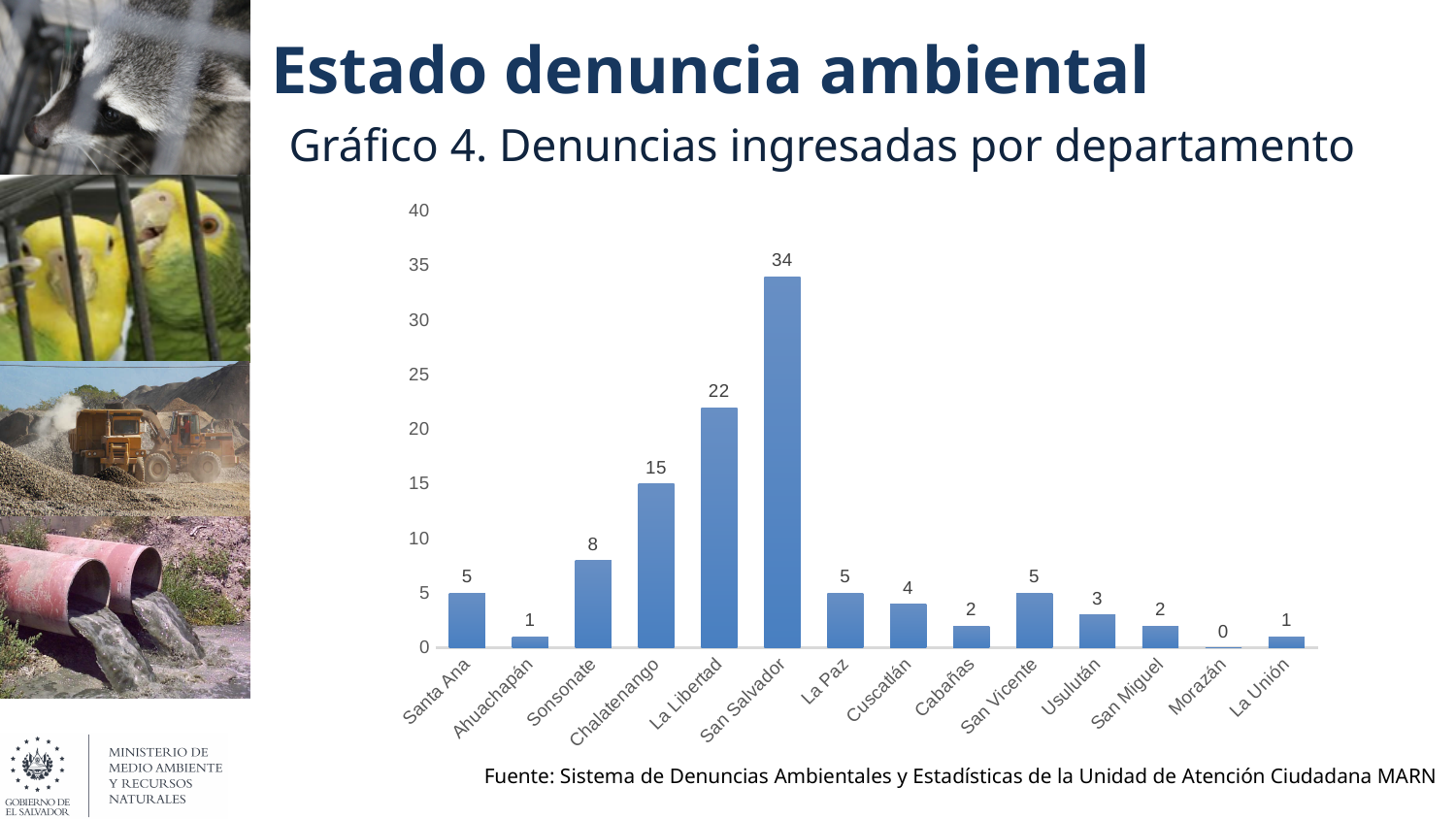
What is the title of the chart? Gráfico 4. Denuncias ingresadas por departamento Which is larger, the value for Sonsonate or the value for Cuscatlán? Sonsonate What kind of chart is this? Bar chart Is the value for La Libertad greater or less than 20? greater What is the value for Morazán? 0 How many departments are shown on the x axis? 14 What is the value for San Salvador? 34 Which department has the highest value? San Salvador What is the value for Usulután? 3 What is the value for Chalatenango? 15 Which department has the lowest value? Morazán What is the difference between the values for San Salvador and La Libertad? 12